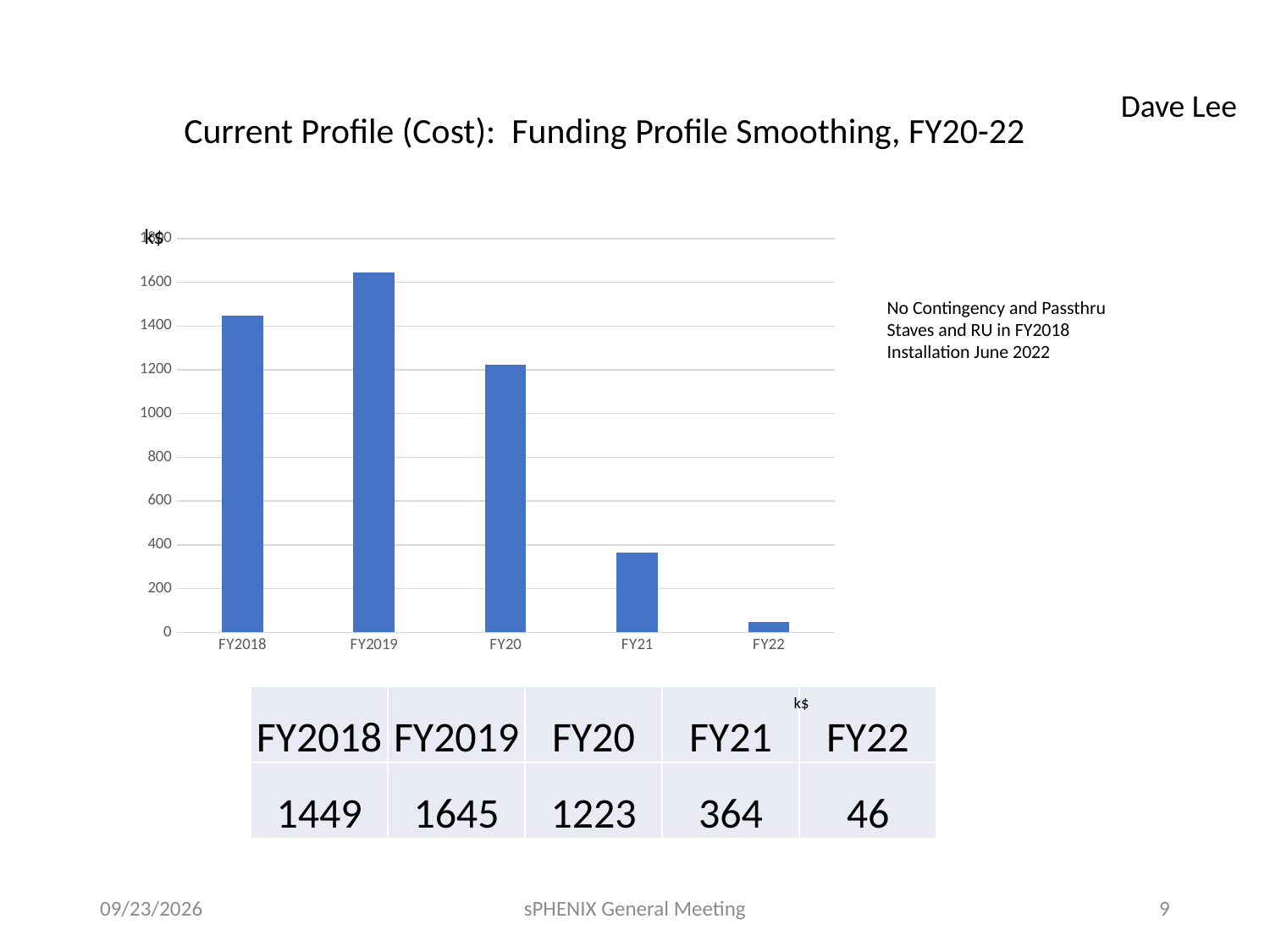
What is the value for FY21? 364 What is the value for FY22? 46 Which fiscal year has the lowest value? FY22 What kind of chart is shown on the slide? bar chart What is the difference between the values for FY20 and FY21? 859 What is the value for FY2019? 1645 How many fiscal years are shown on the x axis? 5 Which is larger, the value for FY2018 or the value for FY20? FY2018 What is the difference between the values for FY2019 and FY2018? 196 Do the values rise or fall from FY2019 to FY22? fall Which fiscal year has the highest value? FY2019 Is the value for FY20 greater or less than 1000? greater